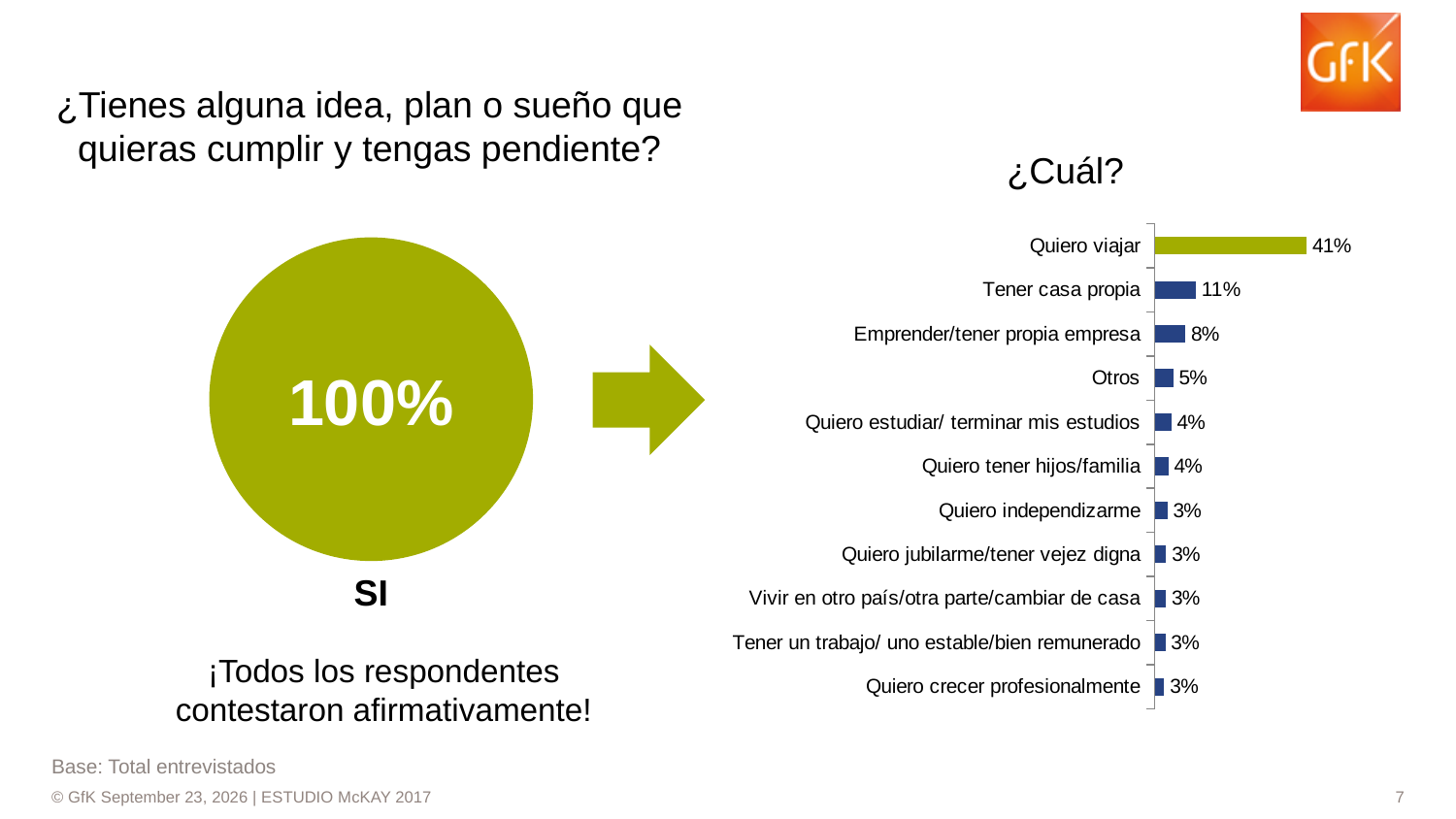
In the "¿Cuál?" chart, what is the difference between "Quiero viajar" and "Tener casa propia"? 30% What type of chart is the "¿Cuál?" chart? Bar chart In the "¿Cuál?" chart, which is larger: "Otros" or "Quiero estudiar/ terminar mis estudios"? Otros How many categories are shown in the "¿Cuál?" chart? 11 In the "¿Cuál?" chart, which category has the highest value? Quiero viajar In the "¿Cuál?" chart, what is the value for "Quiero tener hijos/familia"? 4% In the "¿Cuál?" chart, what is the difference between "Tener casa propia" and "Emprender/tener propia empresa"? 3% In the "¿Cuál?" chart, what is the value for "Emprender/tener propia empresa"? 8% In the "¿Cuál?" chart, what is the value for "Tener casa propia"? 11% What is the title of the bar chart on the right side of the slide? ¿Cuál? In the "¿Cuál?" chart, what is the value for "Quiero viajar"? 41% In the "¿Cuál?" chart, what is the value for "Otros"? 5%